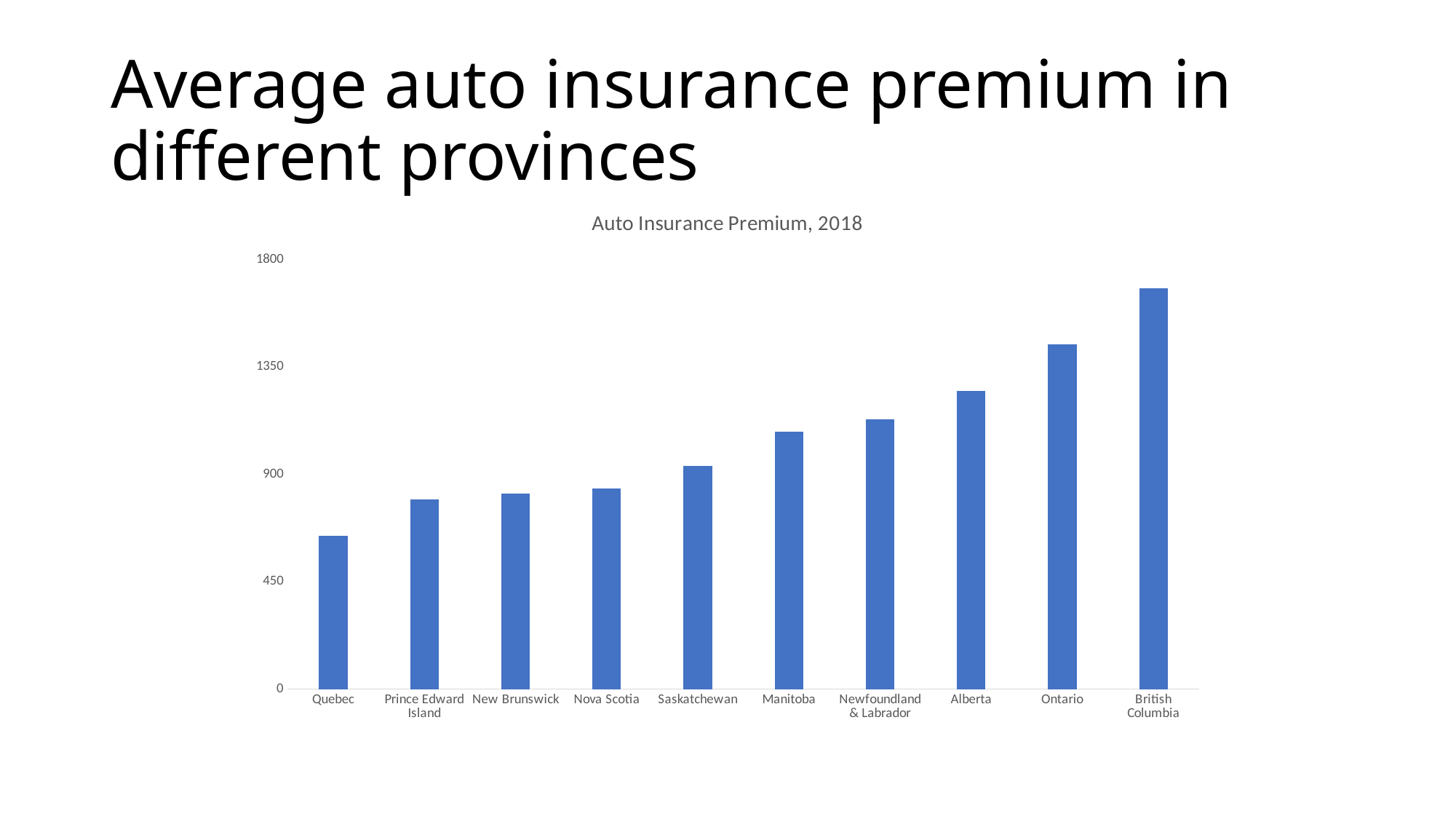
Is the value for Alberta greater or less than 1350? less What is the title of the chart? Auto Insurance Premium, 2018 Is the value for British Columbia greater or less than 1350? greater How many provinces are shown on the chart? 10 Which province has the highest average auto insurance premium? British Columbia Do the values rise or fall moving from left to right along the x axis? Rise Which province has the lowest average auto insurance premium? Quebec What kind of chart is shown on the slide? Bar chart What colour are the bars in the chart? Blue Is the value for Manitoba greater or less than 900? greater Which has a higher average premium, Ontario or Alberta? Ontario